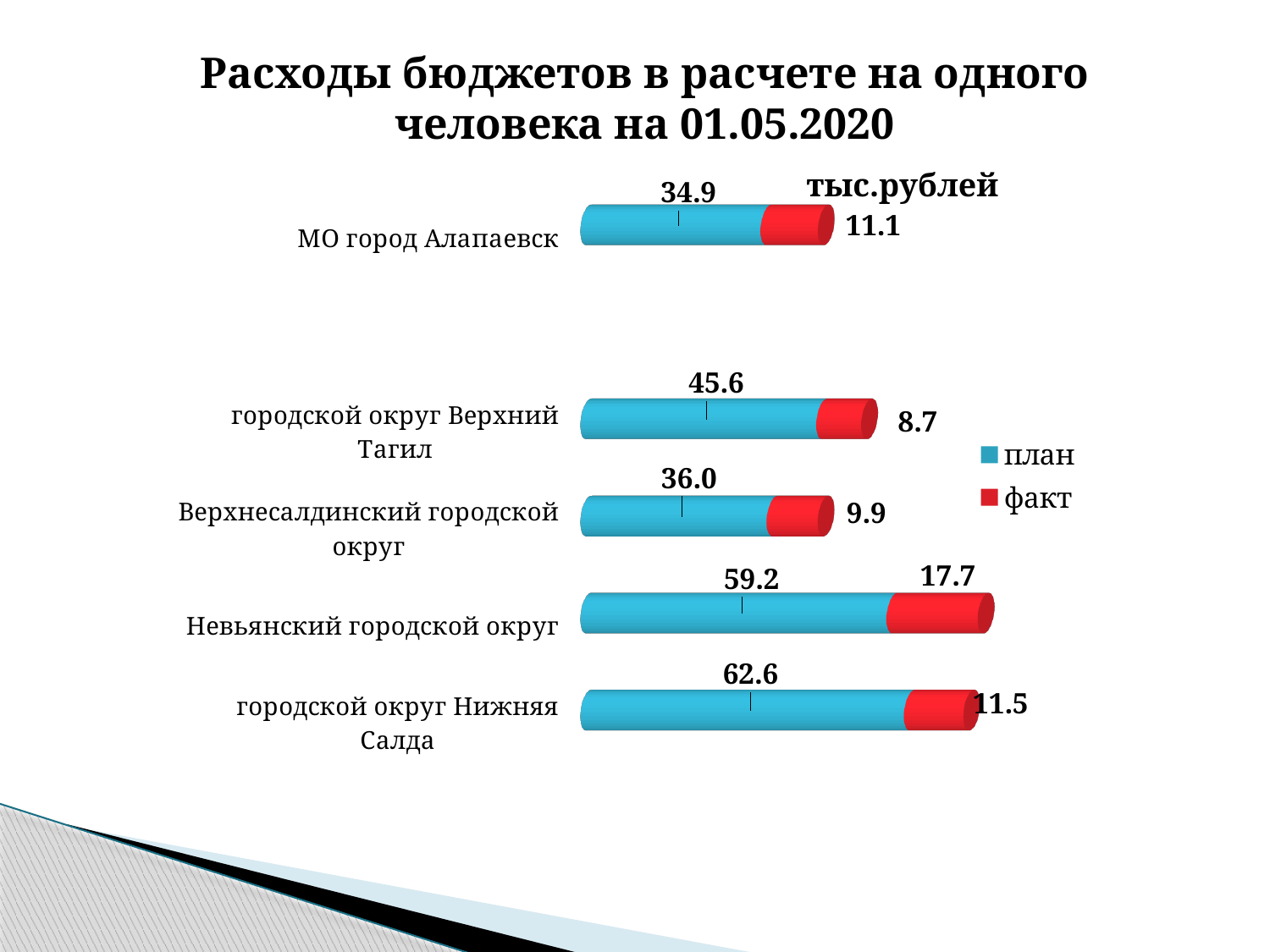
Which category has the highest план value? городской округ Нижняя Салда What is the план value for городской округ Верхний Тагил? 45.6 What is the факт value for МО город Алапаевск? 11.1 How many series does the legend list? 2 What kind of chart is shown on the slide? bar chart What unit is indicated above the chart? тыс.рублей What is the difference between the план and факт values for Невьянский городской округ? 41.5 How many categories are shown in the chart? 5 Which is larger: the факт value for Верхнесалдинский городской округ or the факт value for городской округ Нижняя Салда? городской округ Нижняя Салда Which category has the lowest факт value? городской округ Верхний Тагил What is the total of the stacked bar for МО город Алапаевск? 46.0 What is the план value for Невьянский городской округ? 59.2